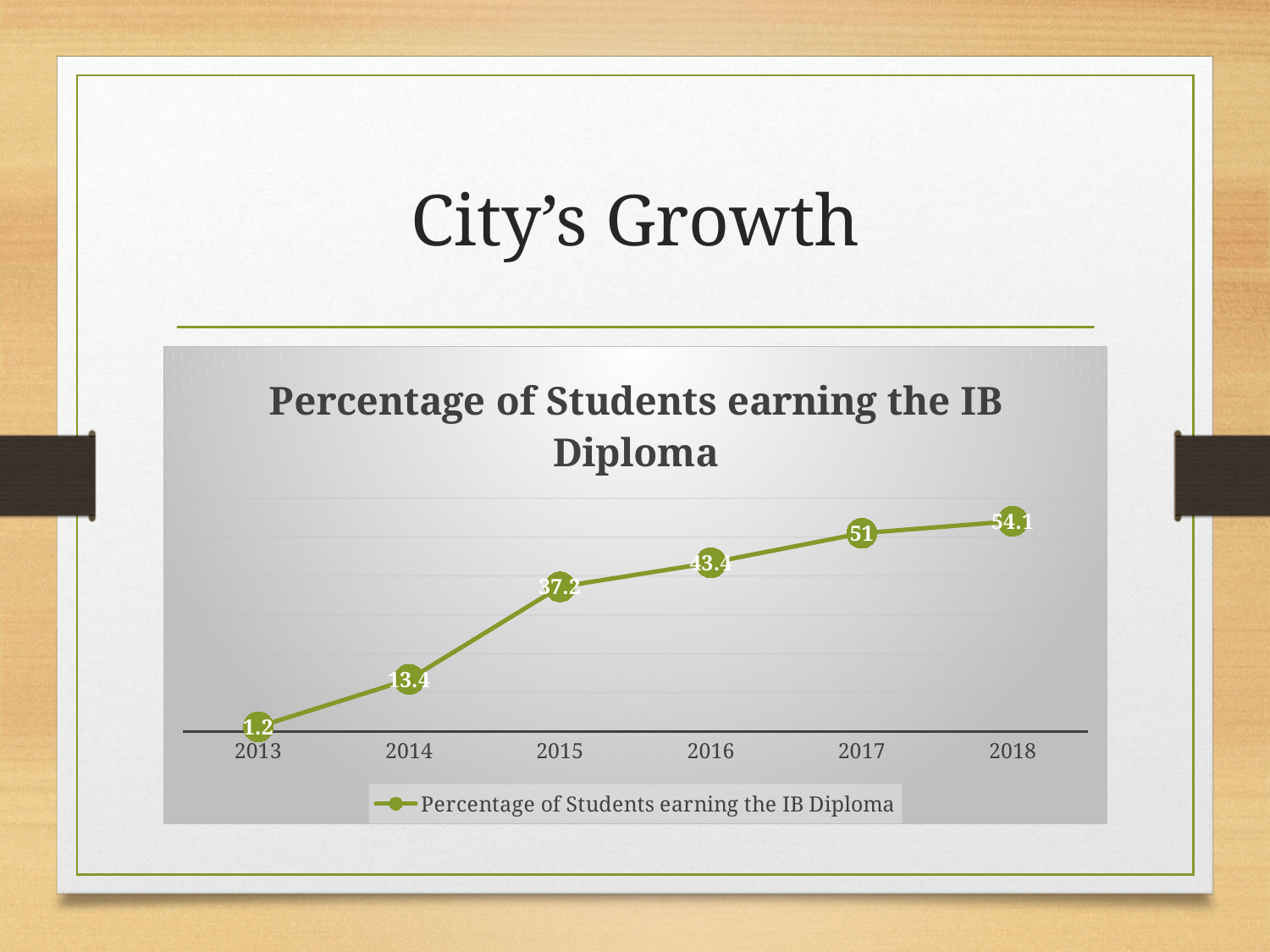
What kind of chart is shown? line chart What is the value for 2013? 1.2 What is the value for 2015? 37.2 Which year has the lowest value? 2013 How many years are plotted on the chart? 6 What is the difference between the values for 2014 and 2013? 12.2 Do the values rise or fall from 2013 to 2018? rise Which is larger, the value for 2015 or the value for 2016? 2016 What is the value for 2018? 54.1 Which year has the highest value? 2018 What is the value for 2017? 51 What is the difference between the values for 2018 and 2017? 3.1